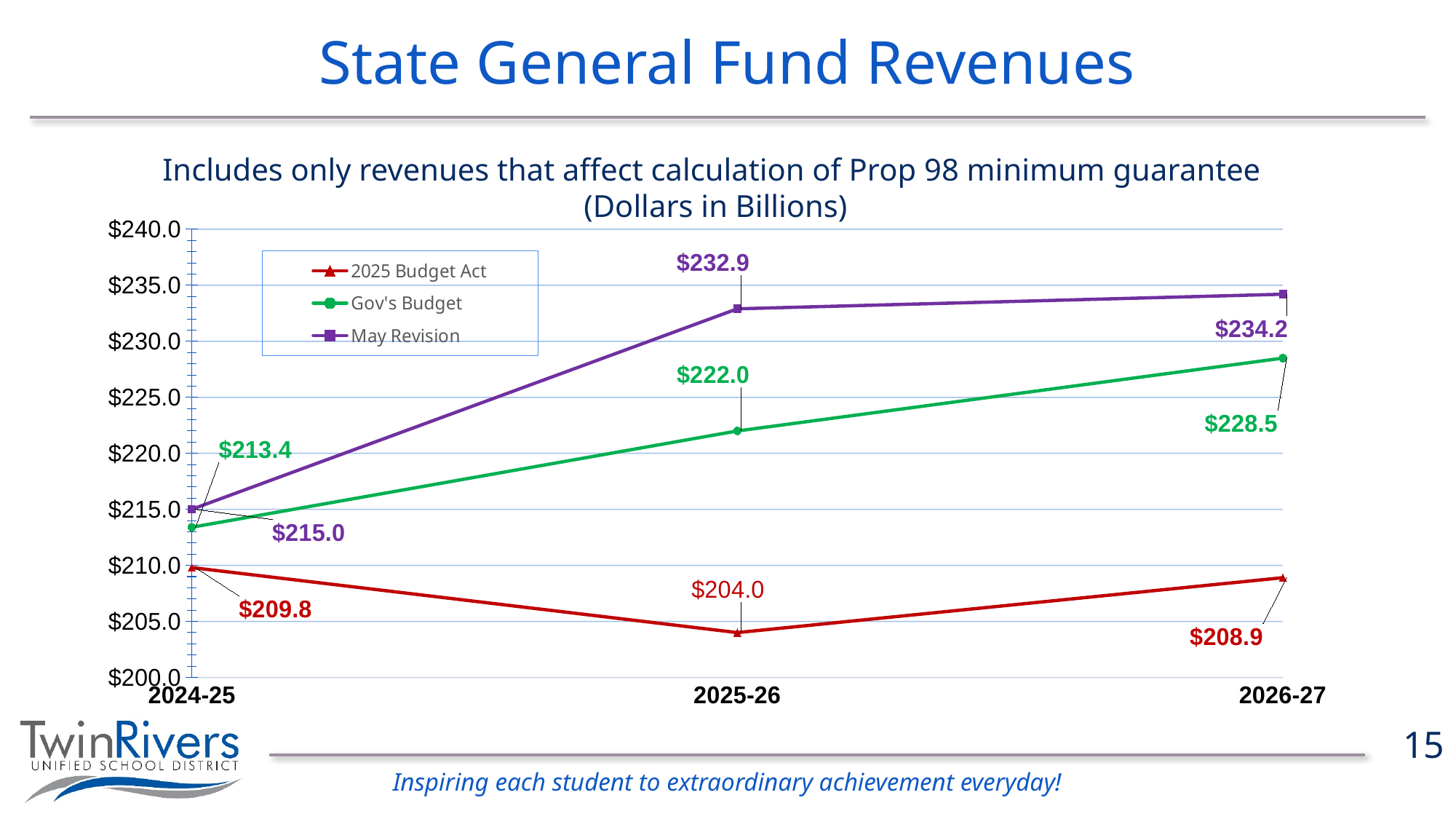
What is the difference between the May Revision and Gov's Budget values for 2025-26? $10.9 What unit are the dollar values in, according to the chart subtitle? Dollars in Billions What is the May Revision value for 2025-26? $232.9 What is the Gov's Budget value for 2026-27? $228.5 Which is larger in 2024-25, the May Revision value or the Gov's Budget value? May Revision What kind of chart is shown on the slide? Line chart Which series has the highest value in 2026-27? May Revision Which fiscal year has the lowest value for the 2025 Budget Act series? 2025-26 Do the Gov's Budget values rise or fall from 2024-25 to 2026-27? Rise How many series does the legend list? 3 What is the 2025 Budget Act value for 2025-26? $204.0 How many fiscal years are plotted along the x axis? 3